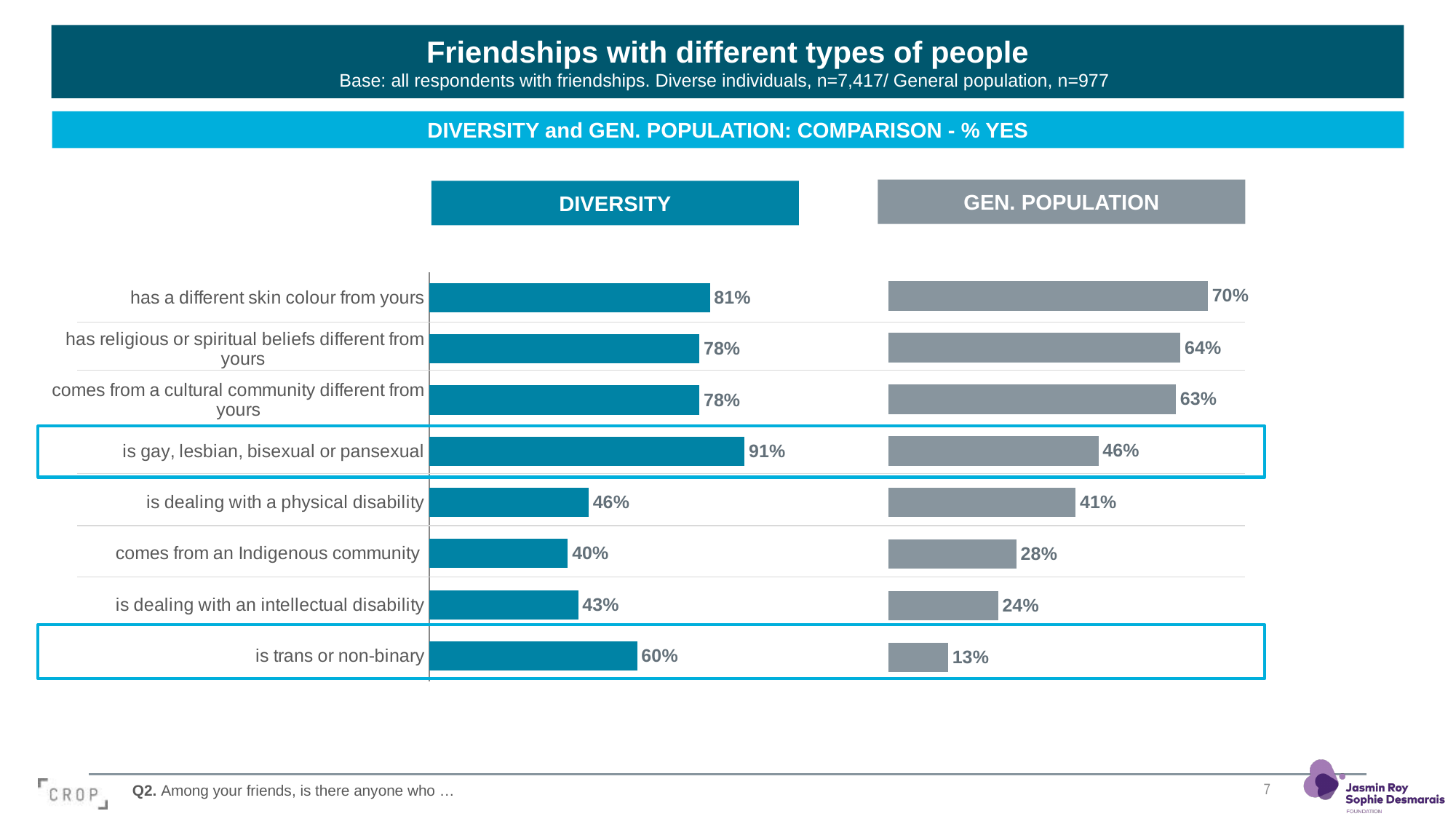
In the GEN. POPULATION chart, which category has the lowest value? is trans or non-binary What is the difference between the DIVERSITY and GEN. POPULATION values for 'is trans or non-binary'? 47 percentage points In the GEN. POPULATION chart, what percentage of respondents have a friend who is trans or non-binary? 13% In the DIVERSITY chart, which is larger: the value for 'is dealing with a physical disability' or 'is dealing with an intellectual disability'? is dealing with a physical disability In the GEN. POPULATION chart, what is the value for 'comes from an Indigenous community'? 28% How many categories are shown in the DIVERSITY chart? 8 In the DIVERSITY chart, which category has the highest value? is gay, lesbian, bisexual or pansexual What is the difference between the DIVERSITY and GEN. POPULATION values for 'is gay, lesbian, bisexual or pansexual'? 45 percentage points What type of chart is used to show the DIVERSITY and GEN. POPULATION comparison? Bar chart In the DIVERSITY chart, what percentage of respondents have a friend who is gay, lesbian, bisexual or pansexual? 91% In the DIVERSITY chart, which category has the lowest value? comes from an Indigenous community In the GEN. POPULATION chart, which category has the highest value? has a different skin colour from yours